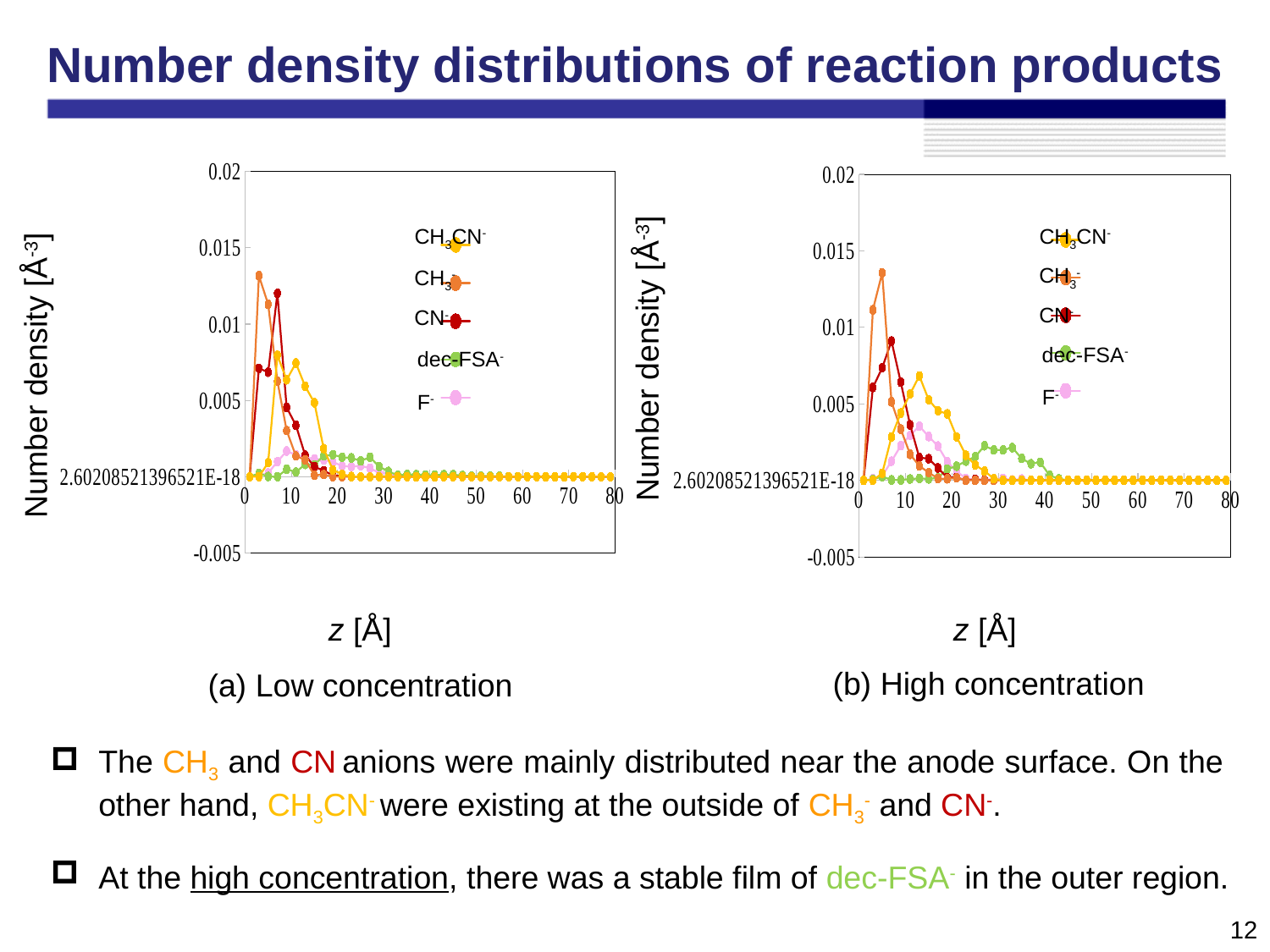
What is the label of the x axis in the (a) Low concentration chart? z [Å] In the (b) High concentration chart, is the peak value of CN- greater or less than 0.005? greater In the (a) Low concentration chart, which series reaches the highest number density? CH3- In the (b) High concentration chart, which series reaches the highest number density? CH3- How many series does the legend list in the (b) High concentration chart? 5 In the (b) High concentration chart, which has the higher peak, CH3- or dec-FSA-? CH3- What kind of chart is shown in panel (a) Low concentration? line chart In the (b) High concentration chart, do the values of CH3- rise or fall along the x axis after z = 10 Å? fall In the (a) Low concentration chart, is the peak value of CH3CN- greater or less than 0.005? greater In the (a) Low concentration chart, is the peak value of CH3- greater or less than 0.01? greater In the (b) High concentration chart, which has the higher peak, CN- or F-? CN-